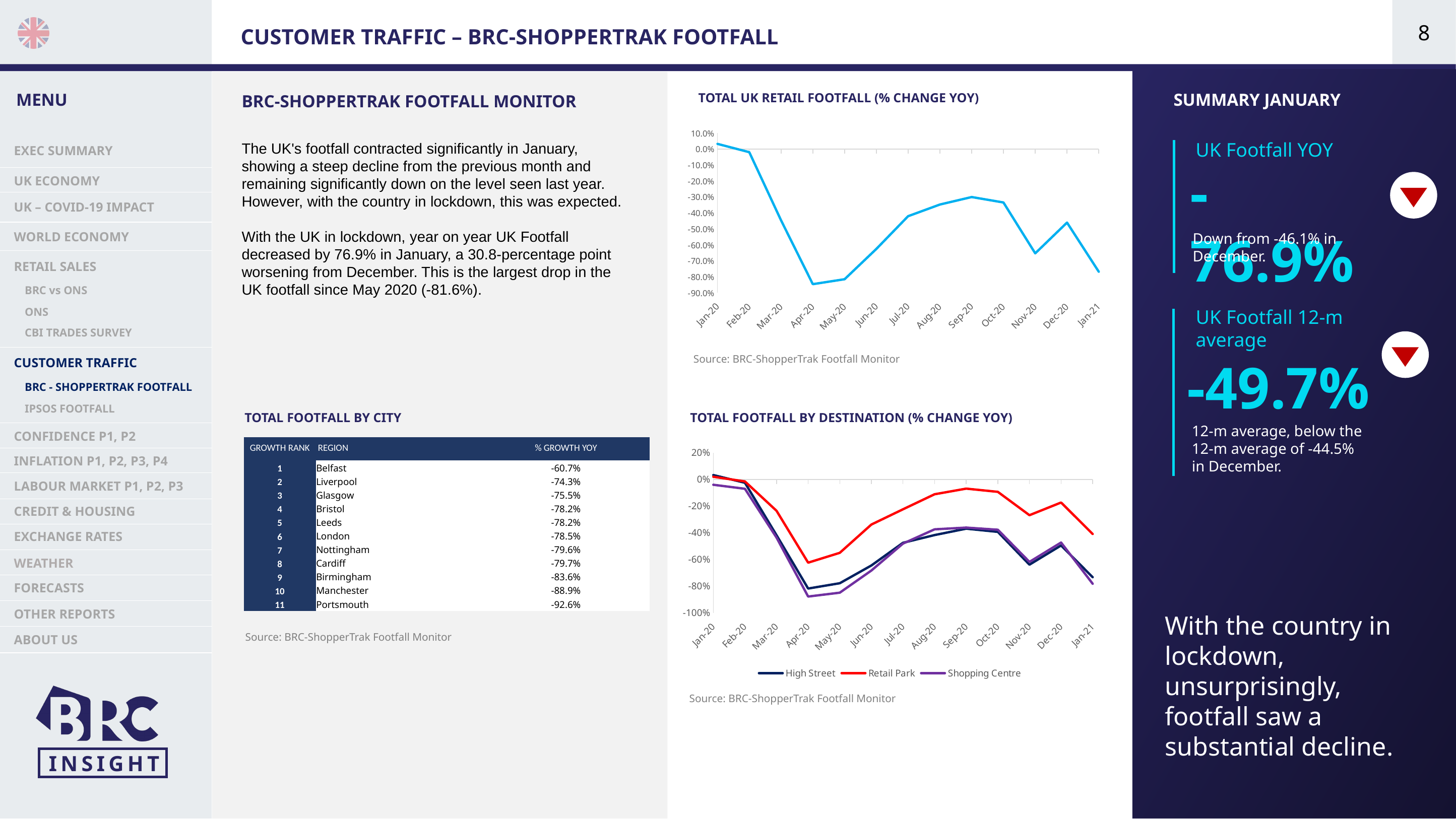
Which series on the 'TOTAL FOOTFALL BY DESTINATION (% CHANGE YOY)' chart has the lowest value in Apr-20? Shopping Centre How many monthly data points are plotted on the 'TOTAL UK RETAIL FOOTFALL (% CHANGE YOY)' chart? 13 On the 'TOTAL UK RETAIL FOOTFALL (% CHANGE YOY)' chart, do the values rise or fall between Apr-20 and Sep-20? Rise What colour is the Retail Park line on the 'TOTAL FOOTFALL BY DESTINATION (% CHANGE YOY)' chart? Red On the 'TOTAL FOOTFALL BY DESTINATION (% CHANGE YOY)' chart, is the Shopping Centre value for Apr-20 greater or less than -80%? less On the 'TOTAL UK RETAIL FOOTFALL (% CHANGE YOY)' chart, is the value for Nov-20 greater or less than -50.0%? less On the 'TOTAL UK RETAIL FOOTFALL (% CHANGE YOY)' chart, is the value for Sep-20 greater or less than -40.0%? greater What kind of chart is the 'TOTAL UK RETAIL FOOTFALL (% CHANGE YOY)' chart? Line chart On the 'TOTAL UK RETAIL FOOTFALL (% CHANGE YOY)' chart, is the value for Dec-20 greater or less than the value for Jan-21? Greater How many series does the legend of the 'TOTAL FOOTFALL BY DESTINATION (% CHANGE YOY)' chart list? 3 On the 'TOTAL FOOTFALL BY DESTINATION (% CHANGE YOY)' chart, which is higher in Apr-20: Retail Park or High Street? Retail Park